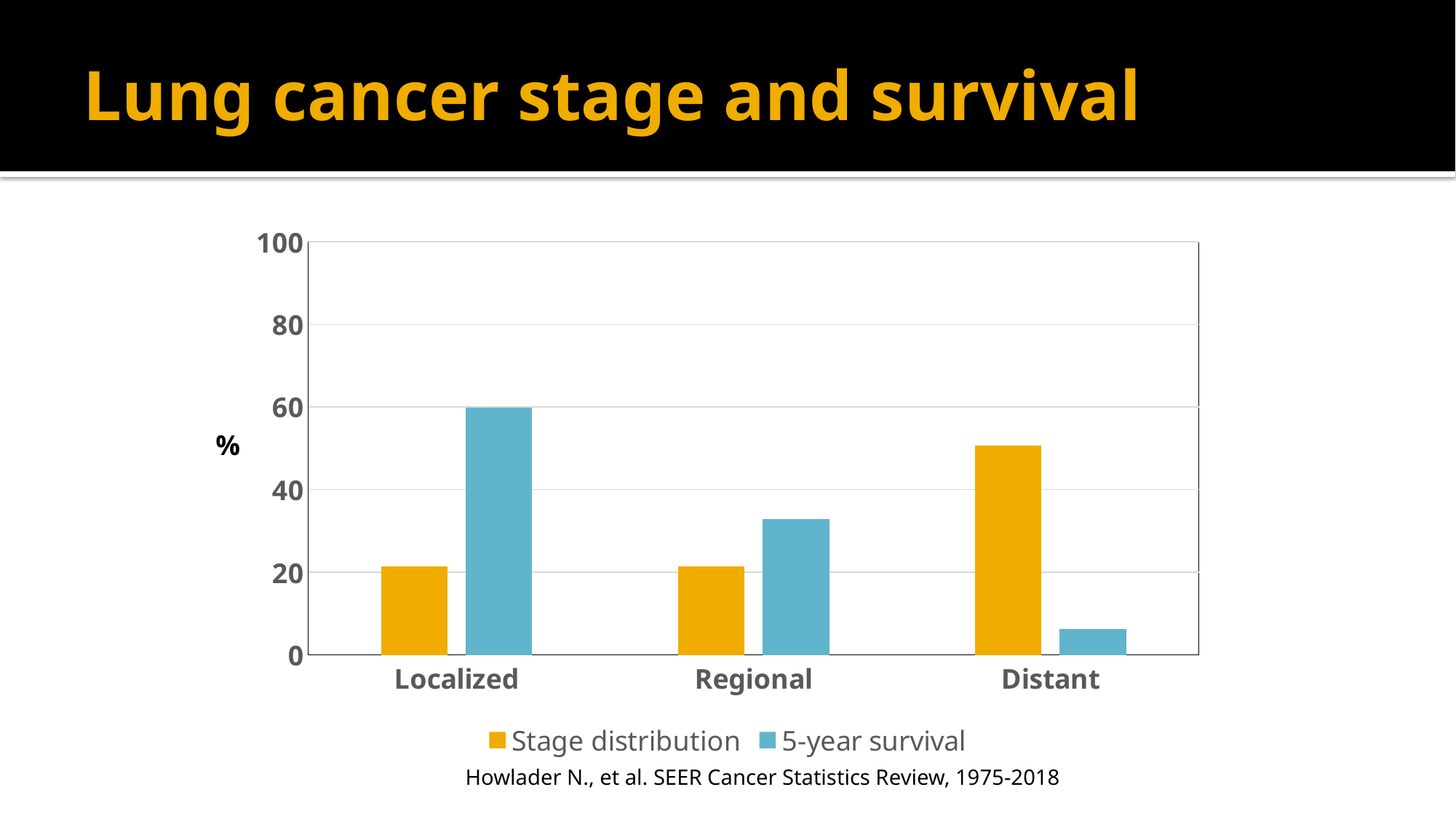
Does 5-year survival rise or fall from Localized to Distant? fall What label is shown on the y axis? % Which stage has the lowest 5-year survival? Distant How many series does the legend list? 2 Is the stage distribution value for Distant greater or less than 40? greater Is the 5-year survival value for Distant greater or less than 20? less For Localized, which is larger: stage distribution or 5-year survival? 5-year survival How many stage categories are shown on the x axis? 3 Which stage has the highest 5-year survival? Localized Which stage has the highest stage distribution value? Distant Is the 5-year survival value for Regional greater or less than 40? less What kind of chart is shown on the slide? bar chart